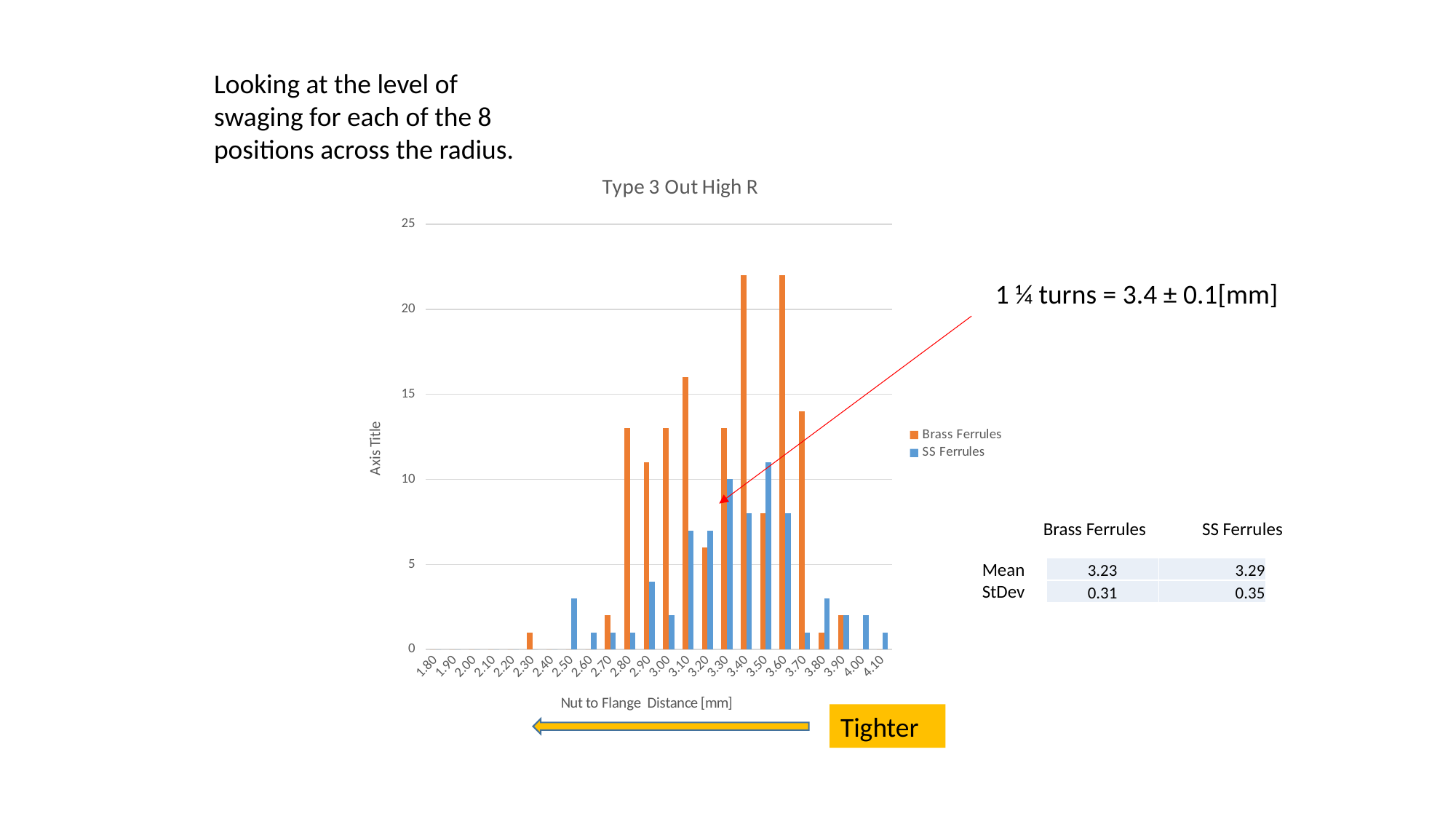
Is the Brass Ferrules value at 2.30 greater or less than 5? less How many series does the chart's legend list? 2 Is the Brass Ferrules value at 3.40 greater or less than 20? greater Which series is shown in orange in the chart? Brass Ferrules How many categories are labelled along the x axis of the chart? 24 Is the SS Ferrules value at 2.50 greater or less than 5? less At 2.50, which series has the larger value, Brass Ferrules or SS Ferrules? SS Ferrules What is the title of the chart? Type 3 Out High R What kind of chart is shown on the slide? bar chart At 3.40, which series has the larger value, Brass Ferrules or SS Ferrules? Brass Ferrules